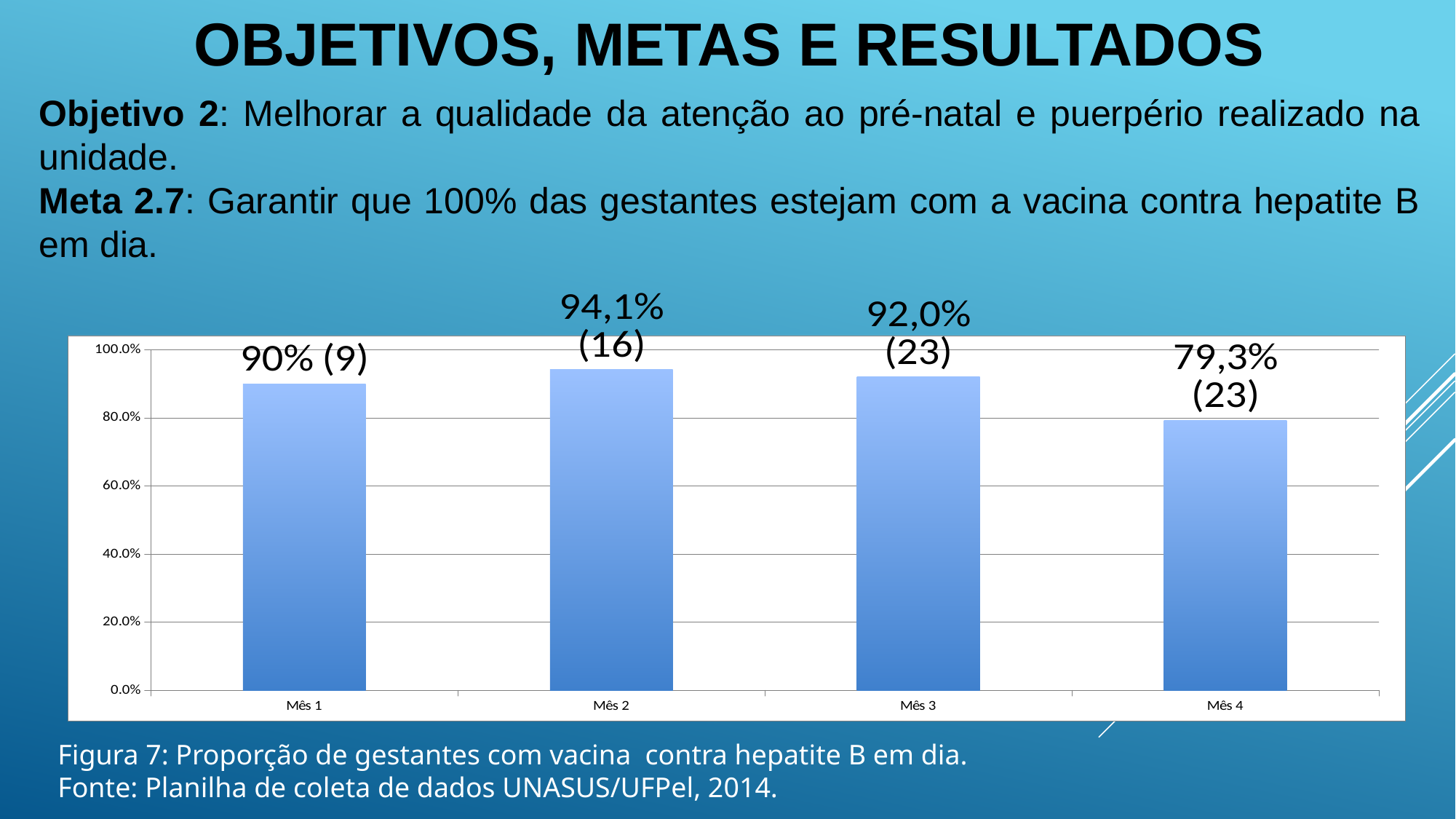
What is the percentage value shown for Mês 4? 79,3% What is the difference in percentage points between Mês 2 and Mês 3? 2,1 According to the caption, what does Figura 7 show? Proporção de gestantes com vacina contra hepatite B em dia What is the percentage value shown for Mês 1? 90% Which month has the highest percentage in the chart? Mês 2 What is the percentage value shown for Mês 2? 94,1% What type of chart is shown on the slide? Bar chart What number appears in parentheses next to the value for Mês 3? 23 Which month has the lowest percentage in the chart? Mês 4 Which is larger, the value for Mês 1 or the value for Mês 3? Mês 3 Is the value for Mês 1 greater or less than 80.0%? greater How many months (categories) are plotted in the chart? 4